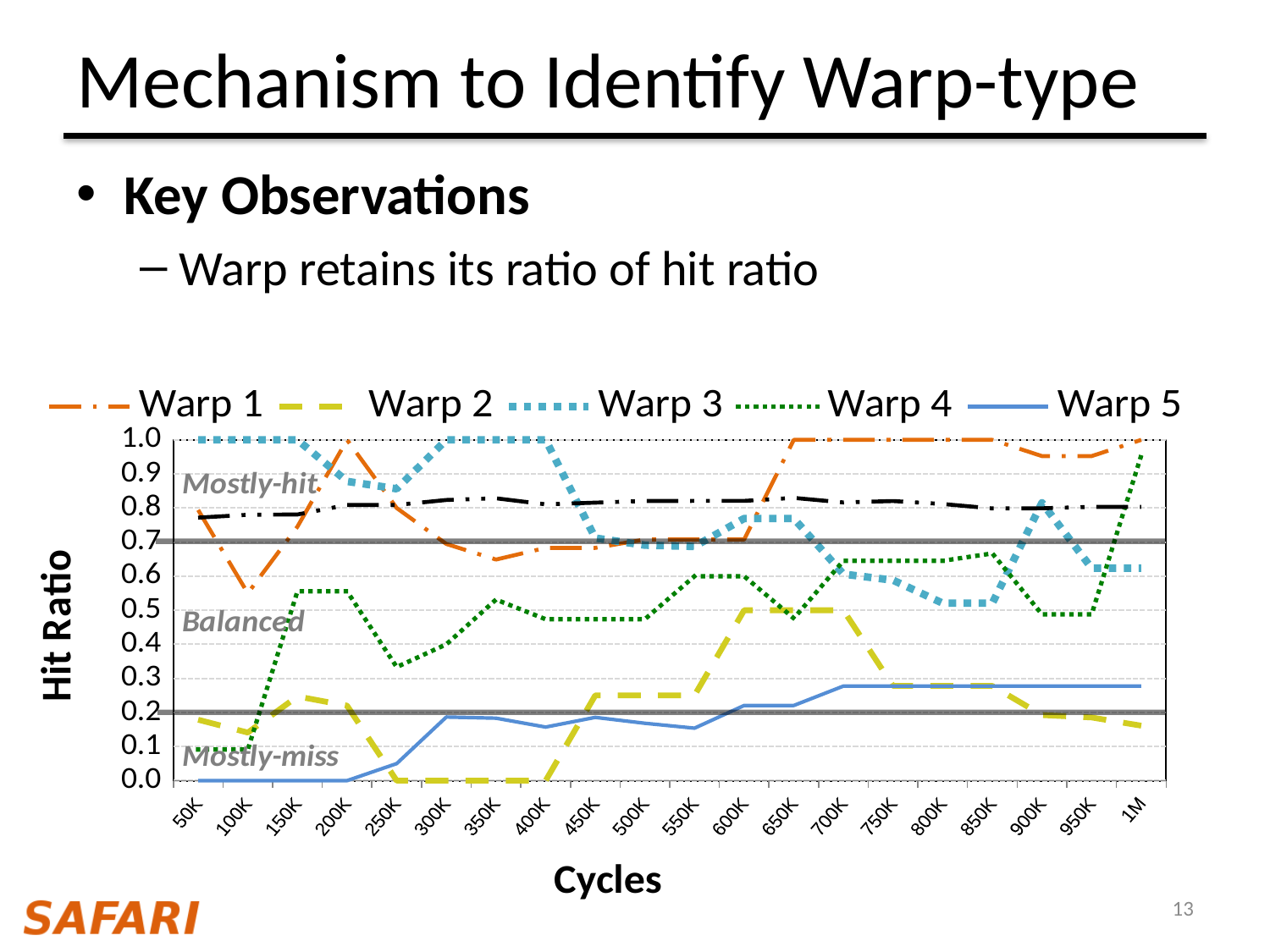
What is the title of the x axis of the chart? Cycles Is the hit ratio of Warp 1 at 100K cycles greater or less than 0.7? less What label is written in the region of the chart above the 0.7 line? Mostly-hit How many cycle points are labelled along the x axis of the chart? 20 Is the hit ratio of Warp 5 at 1M cycles greater or less than 0.2? greater Is the hit ratio of Warp 4 at 250K cycles greater or less than 0.4? less What is the hit ratio of Warp 3 at 50K cycles? 1.0 What kind of chart is shown on the slide? line chart At 1M cycles, which has the higher hit ratio, Warp 4 or Warp 2? Warp 4 How many series does the chart legend list? 5 What is the hit ratio of Warp 5 at 50K cycles? 0.0